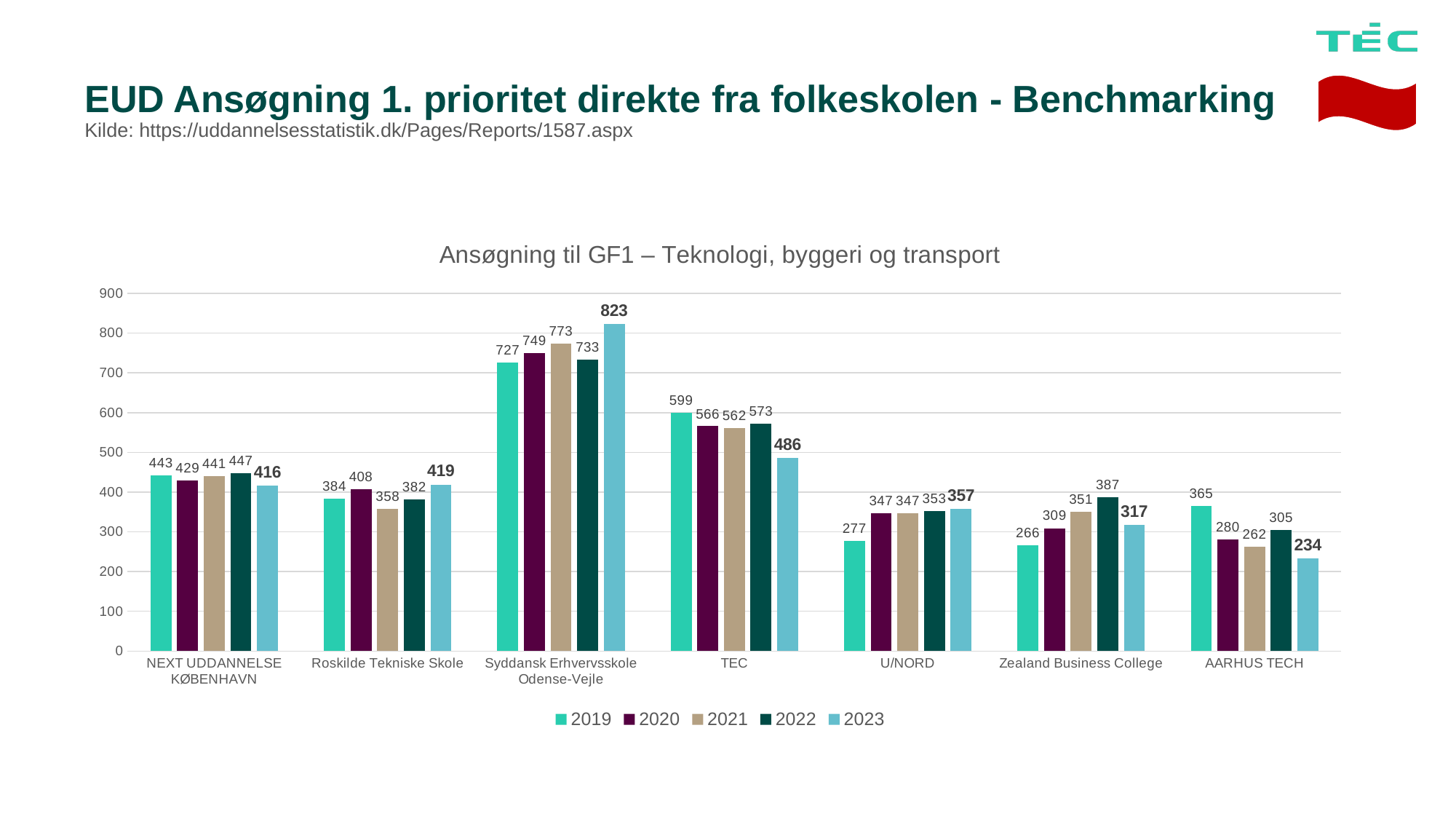
How many series does the legend list? 5 Which school has the highest value in 2023? Syddansk Erhvervsskole Odense-Vejle What is the value for Syddansk Erhvervsskole Odense-Vejle in 2021? 773 Which school has the lowest value in 2023? AARHUS TECH Is the 2023 value for Roskilde Tekniske Skole greater or less than 400? greater How many schools are shown on the x axis? 7 What is the value for TEC in 2023? 486 What is the difference between TEC's 2019 value and its 2023 value? 113 What is the value for AARHUS TECH in 2019? 365 What is the title of the chart? Ansøgning til GF1 – Teknologi, byggeri og transport Which is larger: the 2022 value for Zealand Business College or the 2022 value for U/NORD? Zealand Business College What kind of chart is shown? bar chart